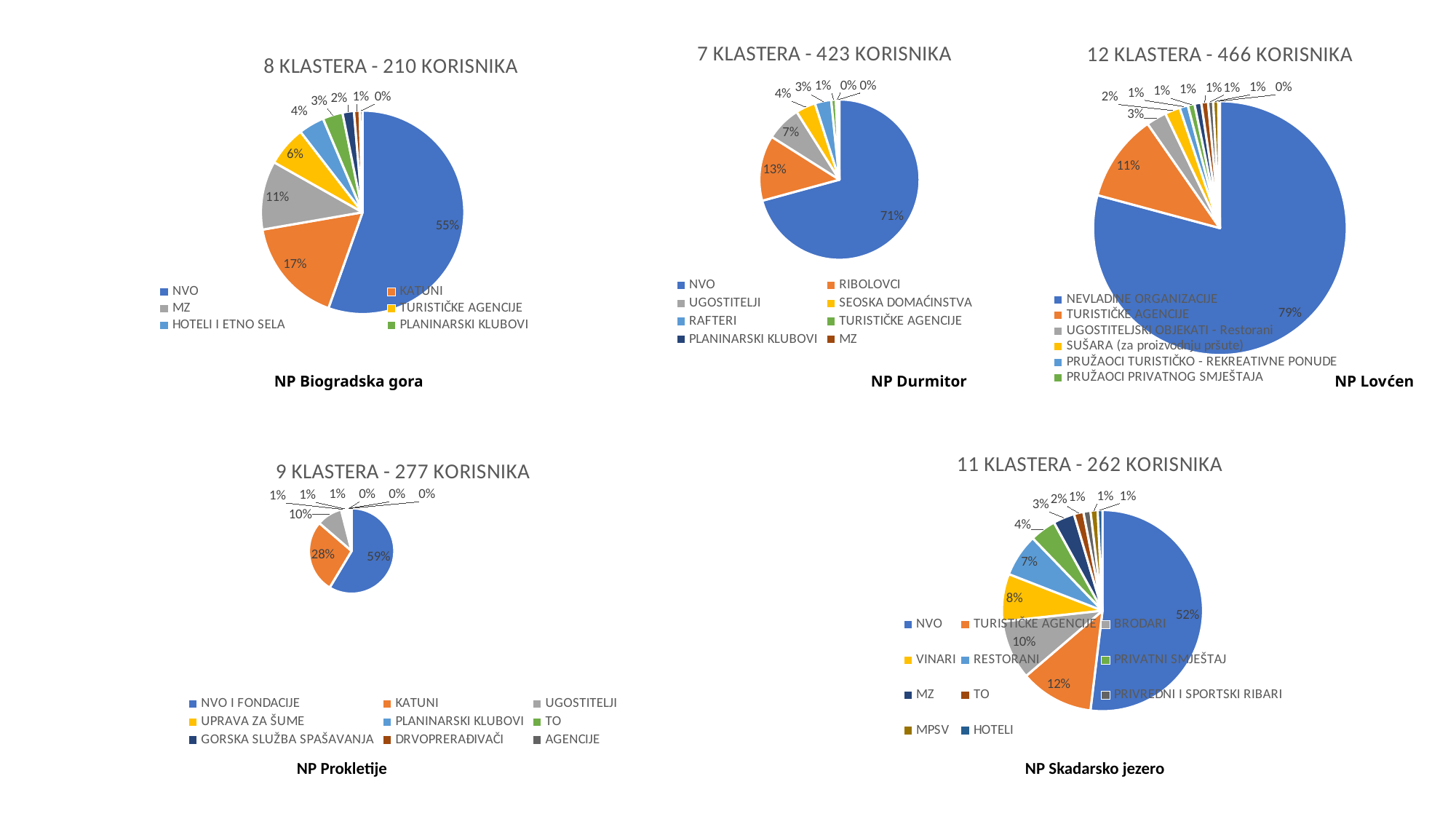
In the NP Prokletije pie chart (9 KLASTERA - 277 KORISNIKA), what share does KATUNI have? 28% In the NP Durmitor pie chart (7 KLASTERA - 423 KORISNIKA), what share does NVO have? 71% In the NP Durmitor pie chart, what share does RIBOLOVCI have? 13% In the NP Prokletije pie chart, which is larger, NVO I FONDACIJE or UGOSTITELJI? NVO I FONDACIJE How many entries does the legend of the NP Skadarsko jezero pie chart list? 11 What kind of chart is used for NP Prokletije? Pie chart In the NP Durmitor pie chart, what is the difference between the NVO share and the UGOSTITELJI share? 64% In the NP Lovćen pie chart, which category has the largest slice? NEVLADINE ORGANIZACIJE